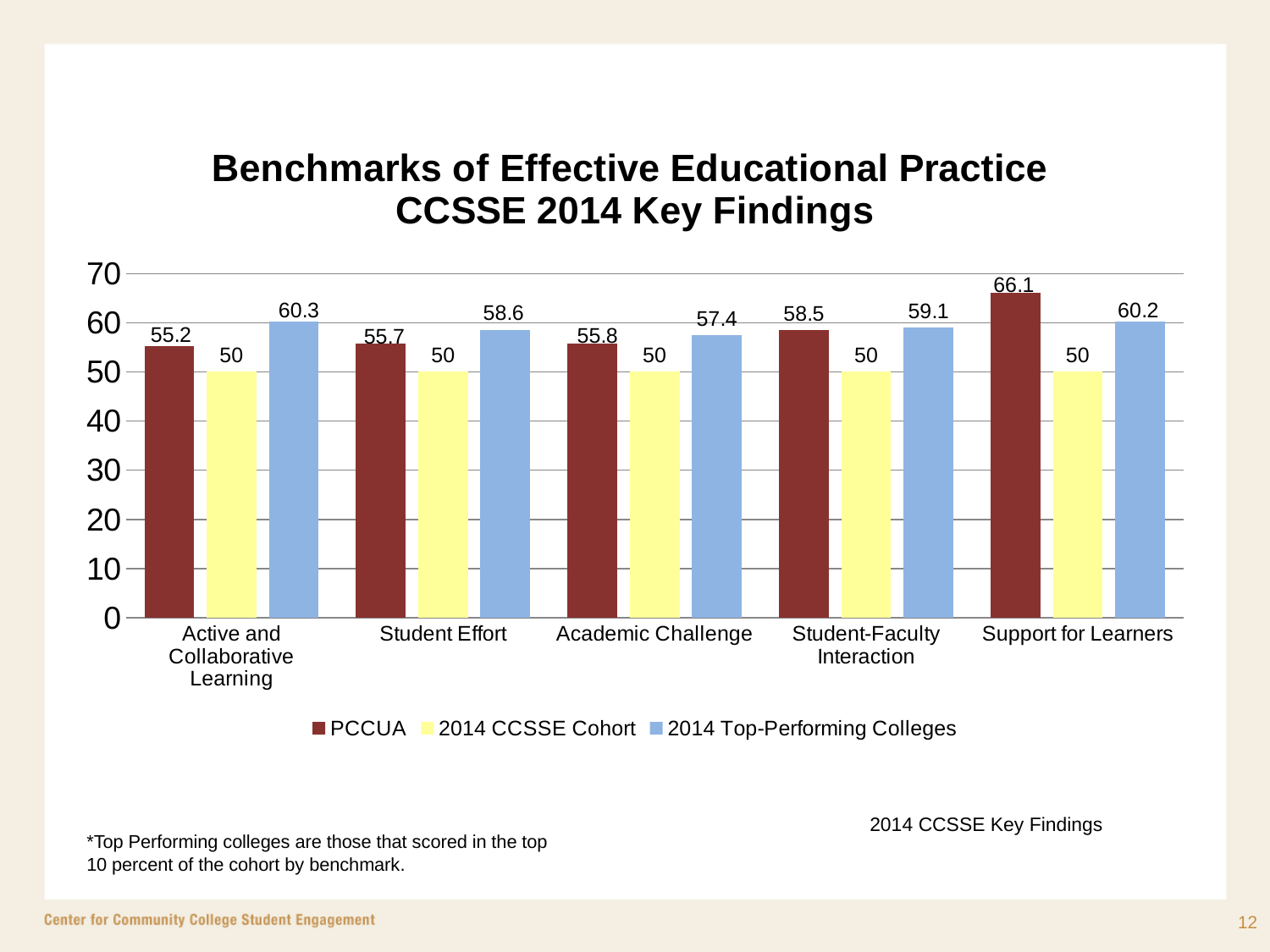
What is the difference between the 2014 Top-Performing Colleges value and the PCCUA value for Active and Collaborative Learning? 5.1 How many series does the legend list? 3 What is the 2014 CCSSE Cohort value for every benchmark? 50 What is the 2014 Top-Performing Colleges value for Academic Challenge? 57.4 What is the PCCUA value for Student-Faculty Interaction? 58.5 Which benchmark has the lowest PCCUA value? Active and Collaborative Learning How many benchmark categories are shown on the x axis? 5 Which benchmark has the highest PCCUA value? Support for Learners What kind of chart is shown on the slide? Bar chart What is the PCCUA value for Support for Learners? 66.1 For Support for Learners, which is larger: the PCCUA value or the 2014 Top-Performing Colleges value? PCCUA For Student Effort, which is larger: the PCCUA value or the 2014 Top-Performing Colleges value? 2014 Top-Performing Colleges